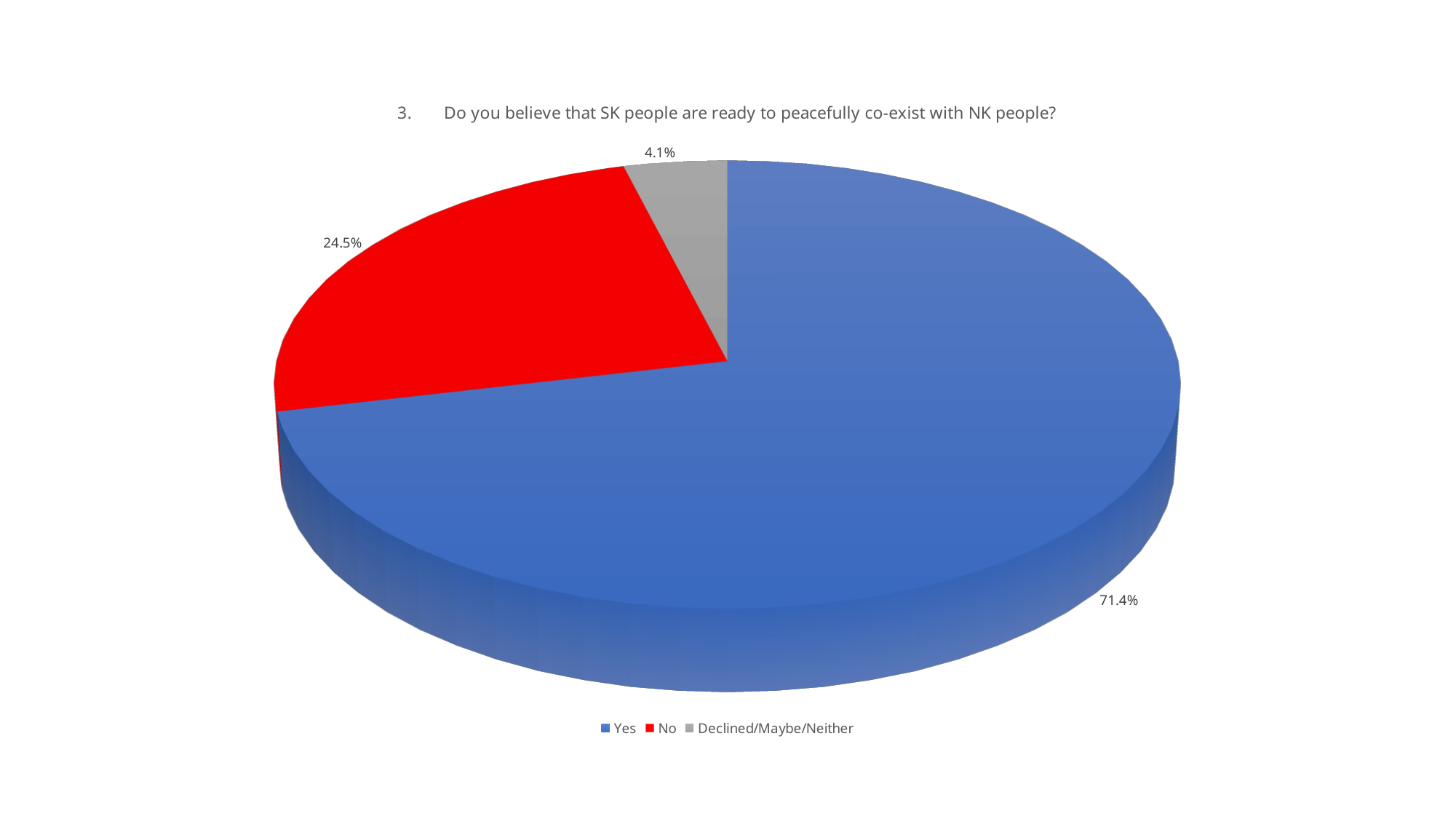
Which is larger, the share for "No" or the share for "Declined/Maybe/Neither"? No What kind of chart is shown on the slide? Pie chart Which response category has the largest share of the pie? Yes Which response category has the smallest share of the pie? Declined/Maybe/Neither What question does the chart title ask? Do you believe that SK people are ready to peacefully co-exist with NK people? What share of respondents answered "No"? 24.5% How many categories does the legend list? 3 What colour is the "No" slice? Red What share of respondents fall under "Declined/Maybe/Neither"? 4.1% What is the difference in percentage points between the "Yes" and "No" shares? 46.9 What is the difference in percentage points between the "No" and "Declined/Maybe/Neither" shares? 20.4 What share of respondents answered "Yes"? 71.4%